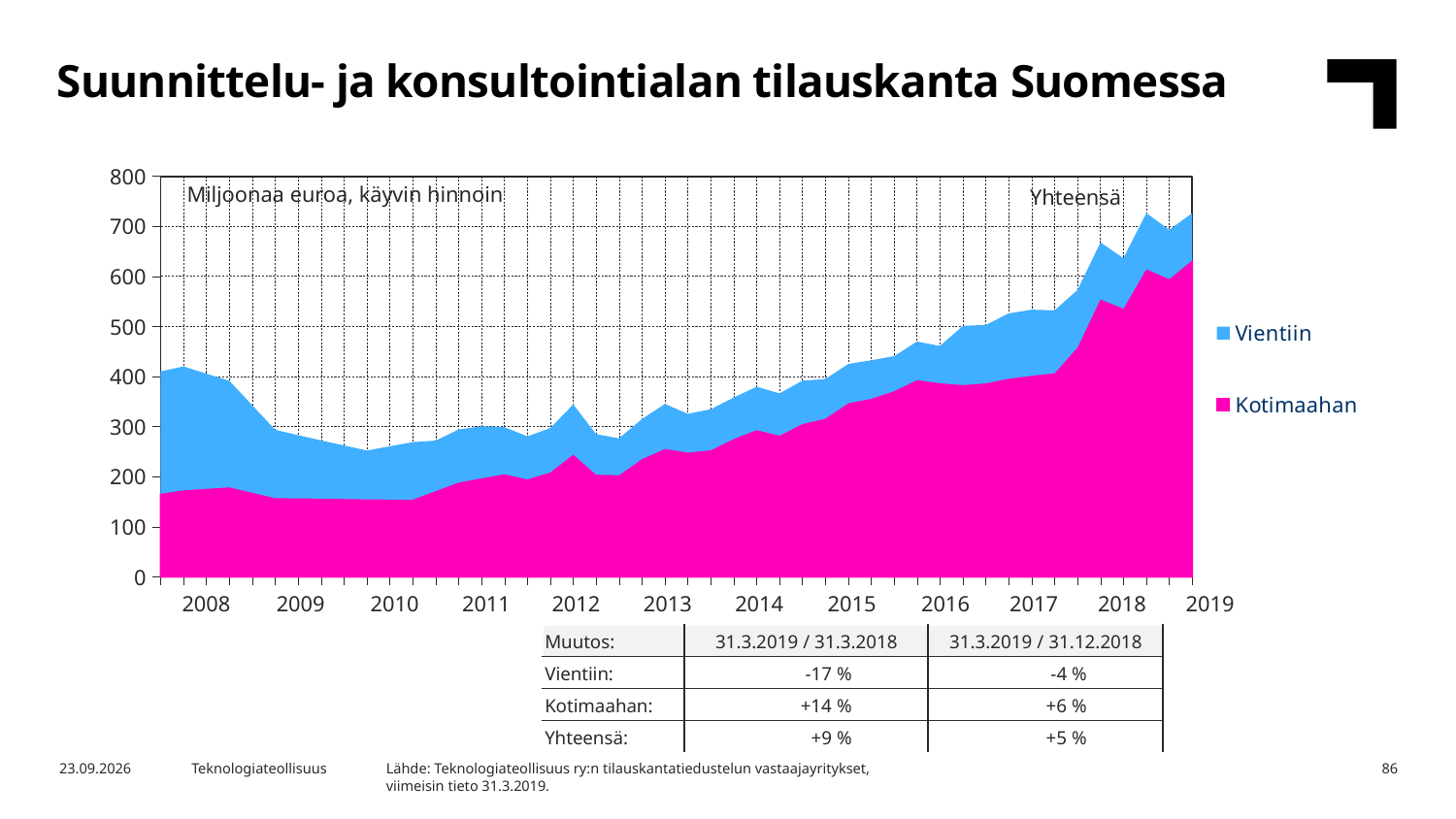
Is the Kotimaahan value at the end of the series (2019) greater or less than 600? greater Is the total (Yhteensä) value at the start of 2008 greater or less than 400? greater How many year labels are shown on the x axis? 12 At the end of the series in 2019, which is larger, the Kotimaahan value or the Vientiin value? Kotimaahan Does the total (Yhteensä) value rise or fall between 2013 and 2019? rise How many series does the chart legend list? 2 Is the total (Yhteensä) value at the end of the series (2019) greater or less than 700? greater What unit is stated in the label at the top left of the chart area? Miljoonaa euroa, käyvin hinnoin Which two series are listed in the chart legend? Vientiin and Kotimaahan What kind of chart is shown on the slide? stacked area chart